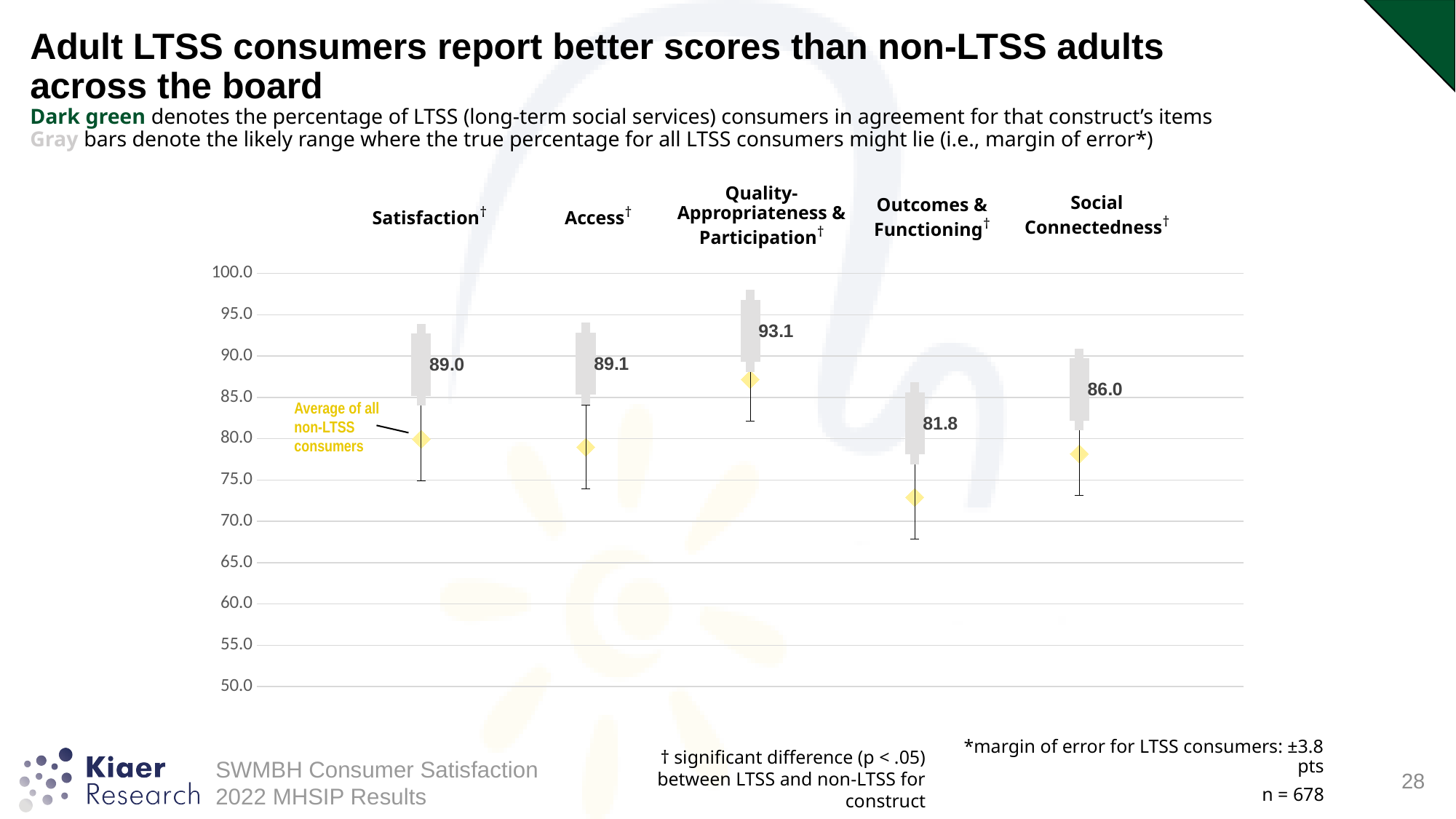
Which is larger, the LTSS score for Access or for Social Connectedness? Access What is the difference between the LTSS scores for Quality-Appropriateness & Participation and Outcomes & Functioning? 11.3 What is the LTSS consumer percentage in agreement for Satisfaction? 89.0 How many constructs are shown on the chart? 5 Is the average of all non-LTSS consumers for Quality-Appropriateness & Participation greater or less than 85.0? greater Which construct has the lowest LTSS consumer score? Outcomes & Functioning What is the LTSS consumer percentage in agreement for Quality-Appropriateness & Participation? 93.1 What is the LTSS consumer percentage in agreement for Outcomes & Functioning? 81.8 Is the average of all non-LTSS consumers for Outcomes & Functioning greater or less than 75.0? less What do the yellow diamonds on the chart represent? Average of all non-LTSS consumers What is the LTSS consumer percentage in agreement for Social Connectedness? 86.0 Which construct has the highest LTSS consumer score? Quality-Appropriateness & Participation